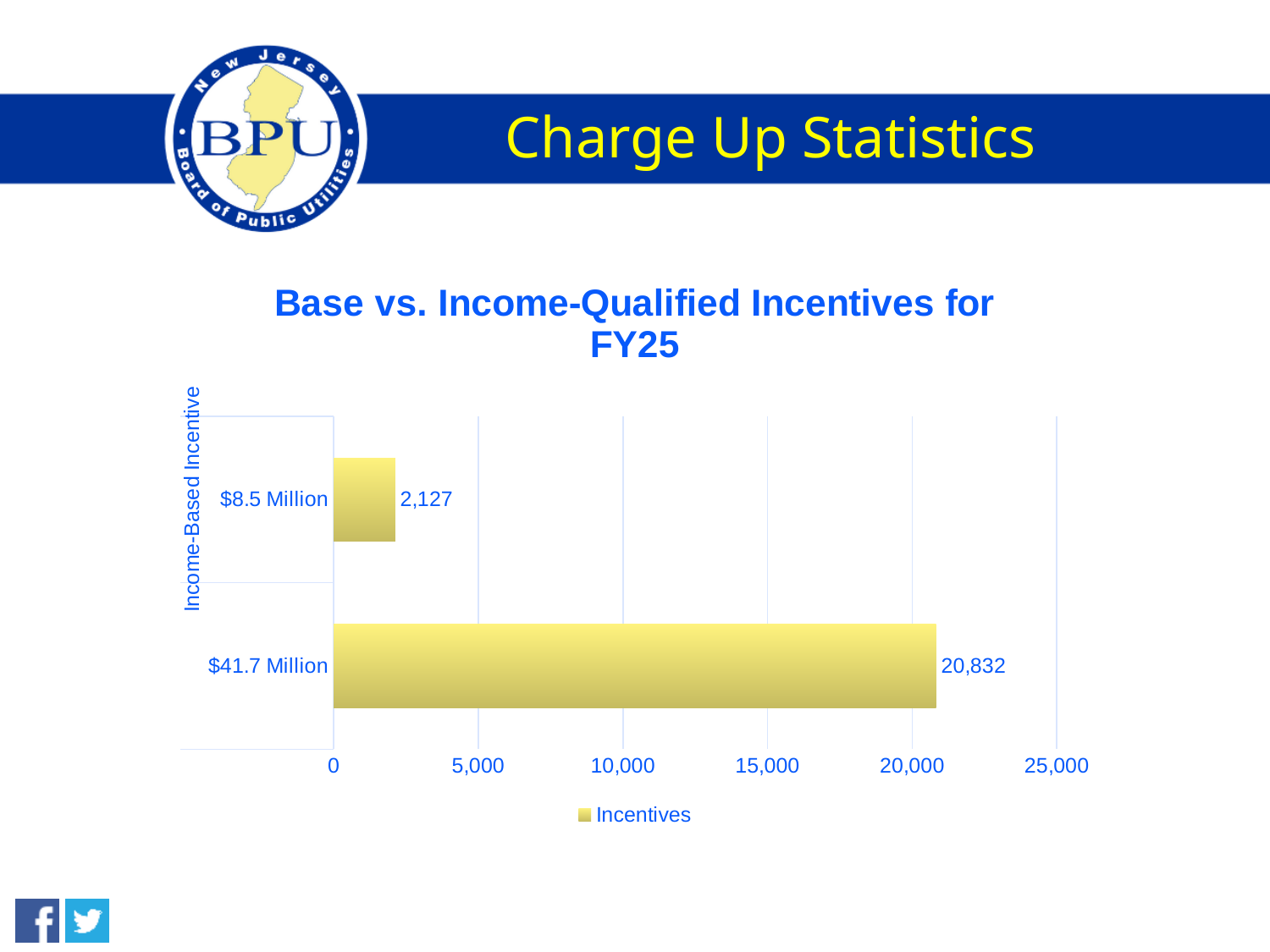
How many series does the legend list? 1 How many categories are shown in the chart? 2 What is the value of the bar labelled "$41.7 Million"? 20,832 Which category has the lowest value? $8.5 Million What kind of chart is shown on the slide? Bar chart Which is larger, the value for "$8.5 Million" or the value for "$41.7 Million"? $41.7 Million What is the value of the bar labelled "$8.5 Million"? 2,127 Is the value for "$8.5 Million" greater or less than 5,000? less What is the title of the chart? Base vs. Income-Qualified Incentives for FY25 Is the value for "$41.7 Million" greater or less than 20,000? greater Which category has the highest value? $41.7 Million What is the difference between the values for "$41.7 Million" and "$8.5 Million"? 18,705